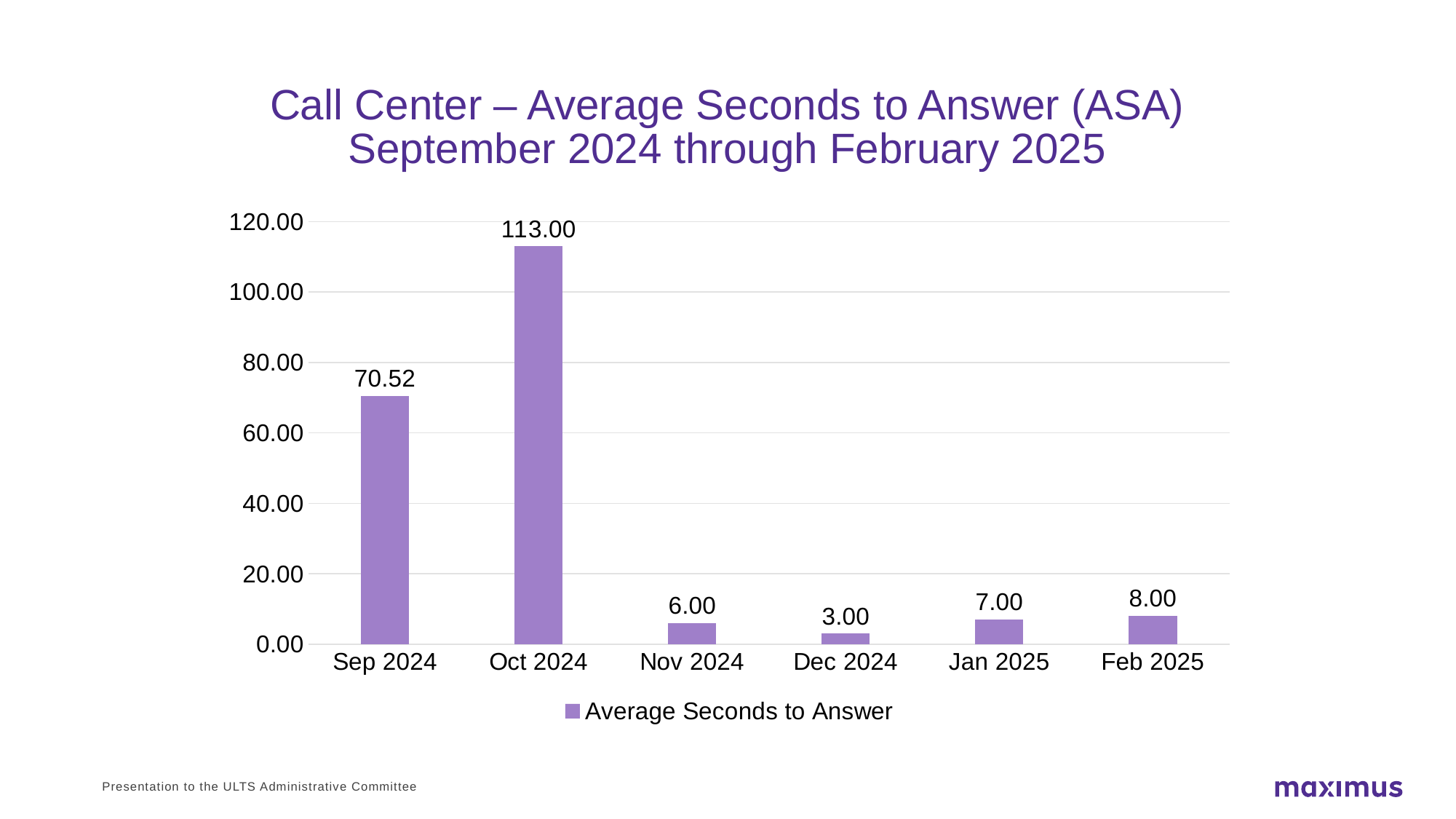
What is the difference between the Average Seconds to Answer for Oct 2024 and Sep 2024? 42.48 Which month has the lowest Average Seconds to Answer? Dec 2024 How many months are shown on the x axis? 6 What kind of chart is shown on the slide? Bar chart What is the Average Seconds to Answer for Oct 2024? 113.00 Which month has the highest Average Seconds to Answer? Oct 2024 Is the value for Sep 2024 greater or less than 80.00? less Which is larger, the Average Seconds to Answer for Jan 2025 or Nov 2024? Jan 2025 What is the Average Seconds to Answer for Dec 2024? 3.00 What is the Average Seconds to Answer for Sep 2024? 70.52 What is the Average Seconds to Answer for Feb 2025? 8.00 What series name does the legend show? Average Seconds to Answer